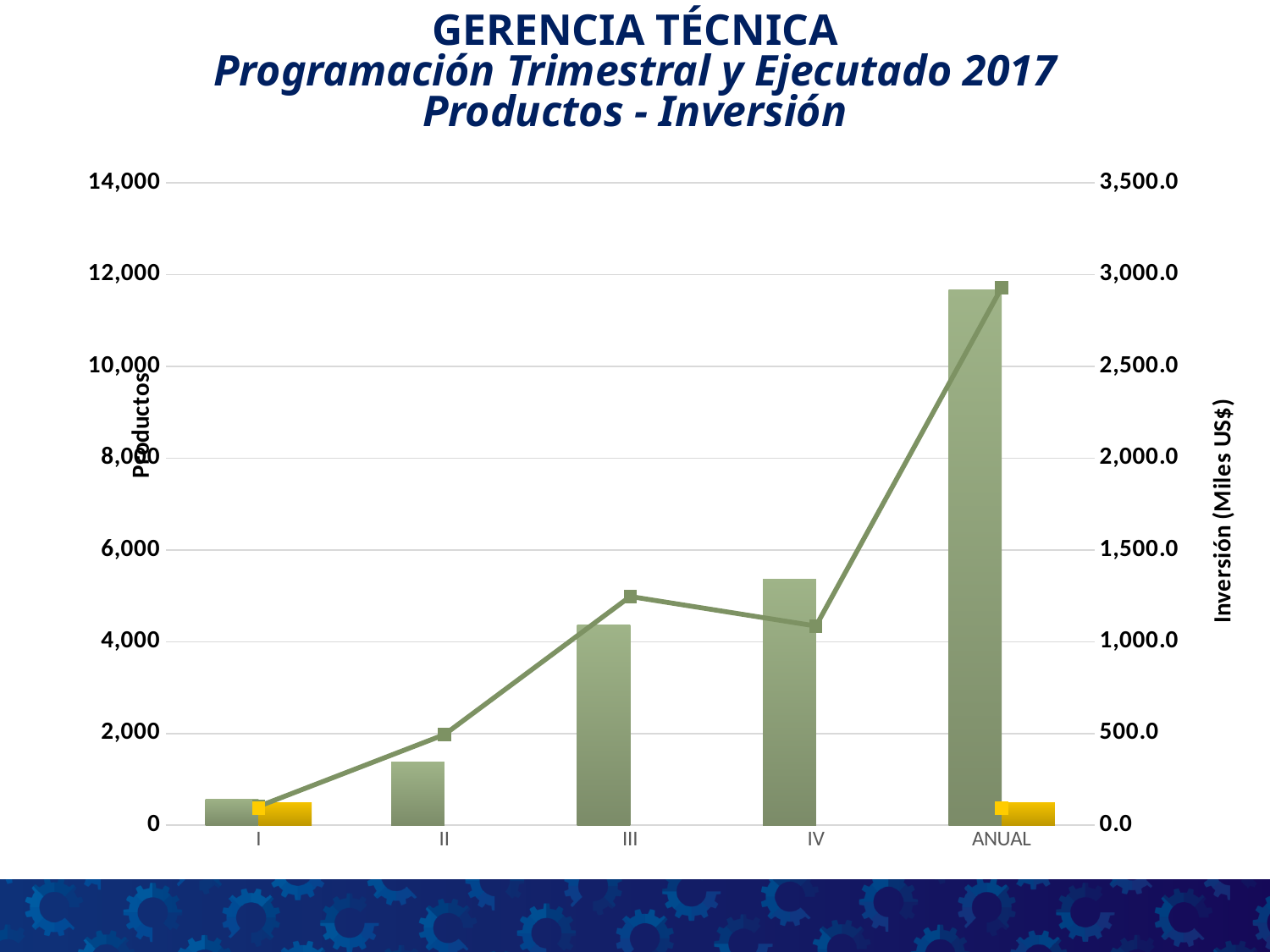
Is the green line value for ANUAL greater or less than 2,500.0 on the right axis? greater What kind of chart is shown on the slide? A combination bar and line chart What is the title of the right-hand vertical axis? Inversión (Miles US$) Do the green bars rise or fall from quarter I to quarter IV? rise Is the green bar for II greater or less than 2,000 on the left axis? less Which green bar is taller, III or IV? IV Is the green bar for ANUAL greater or less than 10,000 on the left axis? greater At which category does the green line reach its highest point? ANUAL How many categories are shown on the x axis? 5 Which category has the tallest green bar? ANUAL Which category has the shortest green bar? I